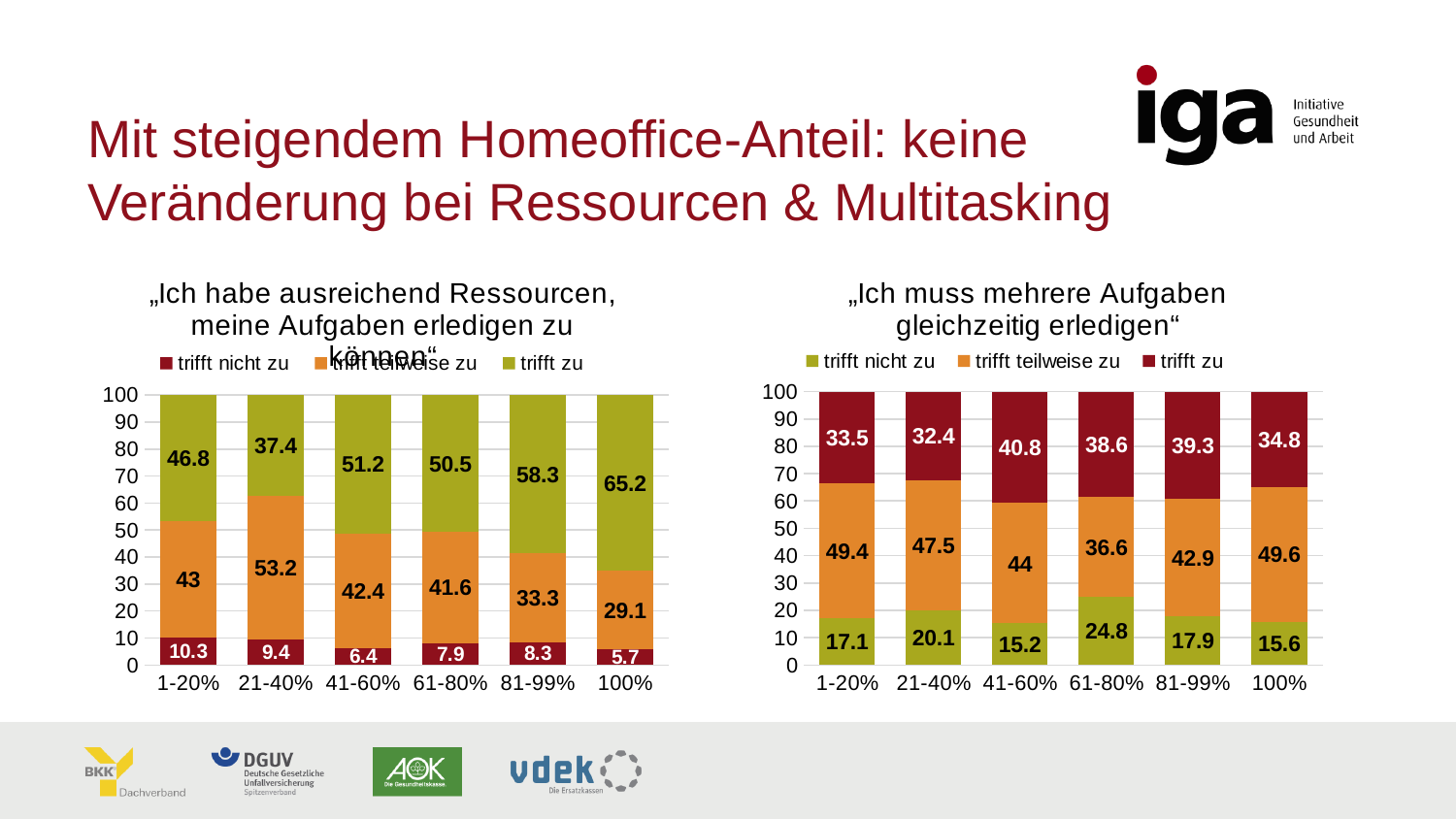
In the left chart ("Ich habe ausreichend Ressourcen..."), what is the value for "trifft zu" in the 100% category? 65.2 How many series does the legend of the left chart ("Ich habe ausreichend Ressourcen...") list? 3 What kind of chart is the right chart ("Ich muss mehrere Aufgaben gleichzeitig erledigen")? Stacked bar chart How many categories are shown on the x axis of the right chart ("Ich muss mehrere Aufgaben gleichzeitig erledigen")? 6 In the left chart ("Ich habe ausreichend Ressourcen..."), what is the difference between the "trifft zu" values for 100% and 1-20%? 18.4 In the right chart ("Ich muss mehrere Aufgaben gleichzeitig erledigen"), which is larger: "trifft zu" for 41-60% or "trifft zu" for 1-20%? 41-60% In the right chart ("Ich muss mehrere Aufgaben gleichzeitig erledigen"), which category has the highest value for "trifft teilweise zu"? 100% In the left chart ("Ich habe ausreichend Ressourcen..."), what is the value for "trifft teilweise zu" in the 21-40% category? 53.2 In the right chart ("Ich muss mehrere Aufgaben gleichzeitig erledigen"), what is the value for "trifft nicht zu" in the 61-80% category? 24.8 In the left chart ("Ich habe ausreichend Ressourcen..."), which category has the highest value for "trifft zu"? 100% In the left chart ("Ich habe ausreichend Ressourcen..."), which category has the lowest value for "trifft nicht zu"? 100% In the right chart ("Ich muss mehrere Aufgaben gleichzeitig erledigen"), what is the value for "trifft zu" in the 41-60% category? 40.8